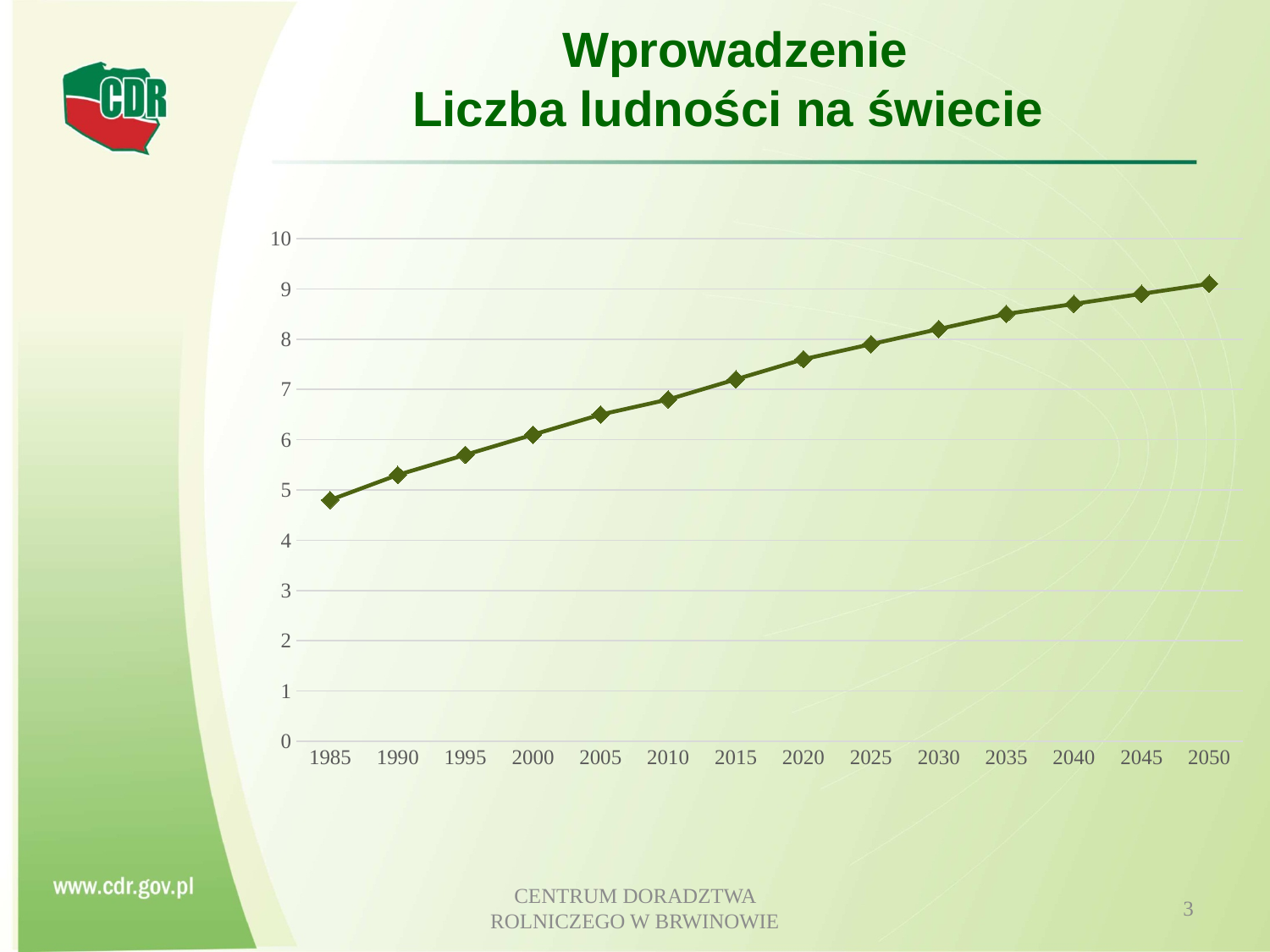
How many data points are plotted on the chart? 14 Is the value for 2030 greater or less than 8? greater Which year has the highest value on the chart? 2050 Which year has the lowest value on the chart? 1985 Which is larger, the value for 2000 or the value for 2030? 2030 What is the title of the slide containing the chart? Wprowadzenie Liczba ludności na świecie Do the values rise or fall from 1985 to 2050? rise Is the value for 2010 greater or less than 7? less Is the value for 1995 greater or less than 6? less What kind of chart is shown on the slide? line chart